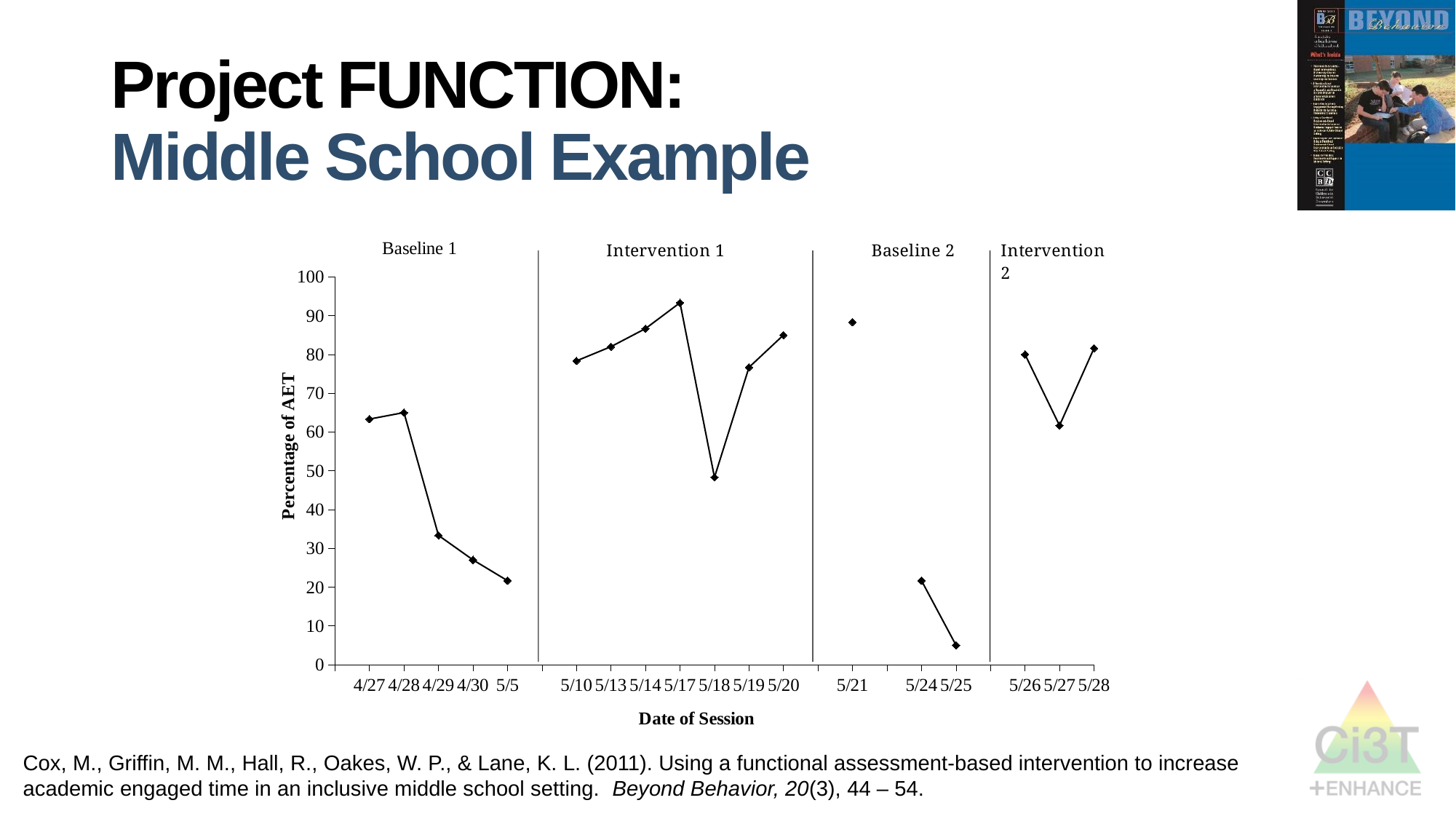
Which date has the larger value, 4/28 or 4/29? 4/28 Is the value for 5/18 greater or less than 60? less Is the value for 5/25 greater or less than 10? less On which date is the percentage of AET highest? 5/17 Is the value for 5/17 greater or less than 90? greater What is the title of the x axis? Date of Session Do the values rise or fall from 4/28 to 5/5 in the Baseline 1 phase? fall What is the title of the y axis? Percentage of AET How many session dates are plotted along the x axis? 18 On which date is the percentage of AET lowest? 5/25 What kind of chart is shown on the slide? Line chart